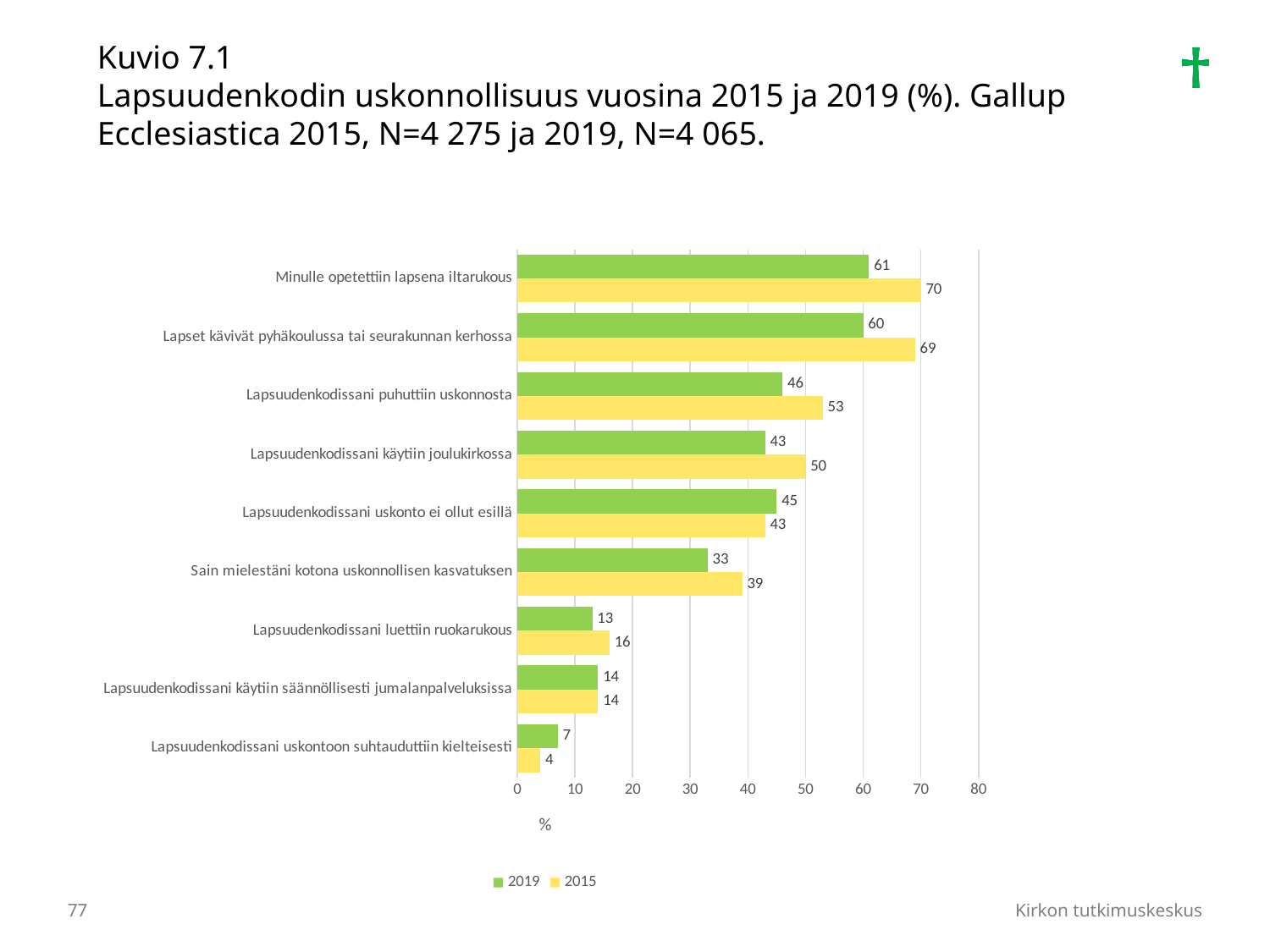
For "Lapsuudenkodissani uskonto ei ollut esillä", which year has the larger value, 2015 or 2019? 2019 How many categories are shown on the chart? 9 Which colour represents the 2019 series in the chart? Green Which category has the highest 2015 value? Minulle opetettiin lapsena iltarukous What is the difference between the 2015 and 2019 values for "Lapset kävivät pyhäkoulussa tai seurakunnan kerhossa"? 9 Which category has the lowest 2019 value? Lapsuudenkodissani uskontoon suhtauduttiin kielteisesti What kind of chart is shown on the slide? Bar chart Is the 2015 value for "Lapsuudenkodissani käytiin joulukirkossa" greater or less than 40? greater What is the 2019 value for "Minulle opetettiin lapsena iltarukous"? 61 How many series does the legend list? 2 What is the 2015 value for "Sain mielestäni kotona uskonnollisen kasvatuksen"? 39 What is the 2015 value for "Lapsuudenkodissani puhuttiin uskonnosta"? 53